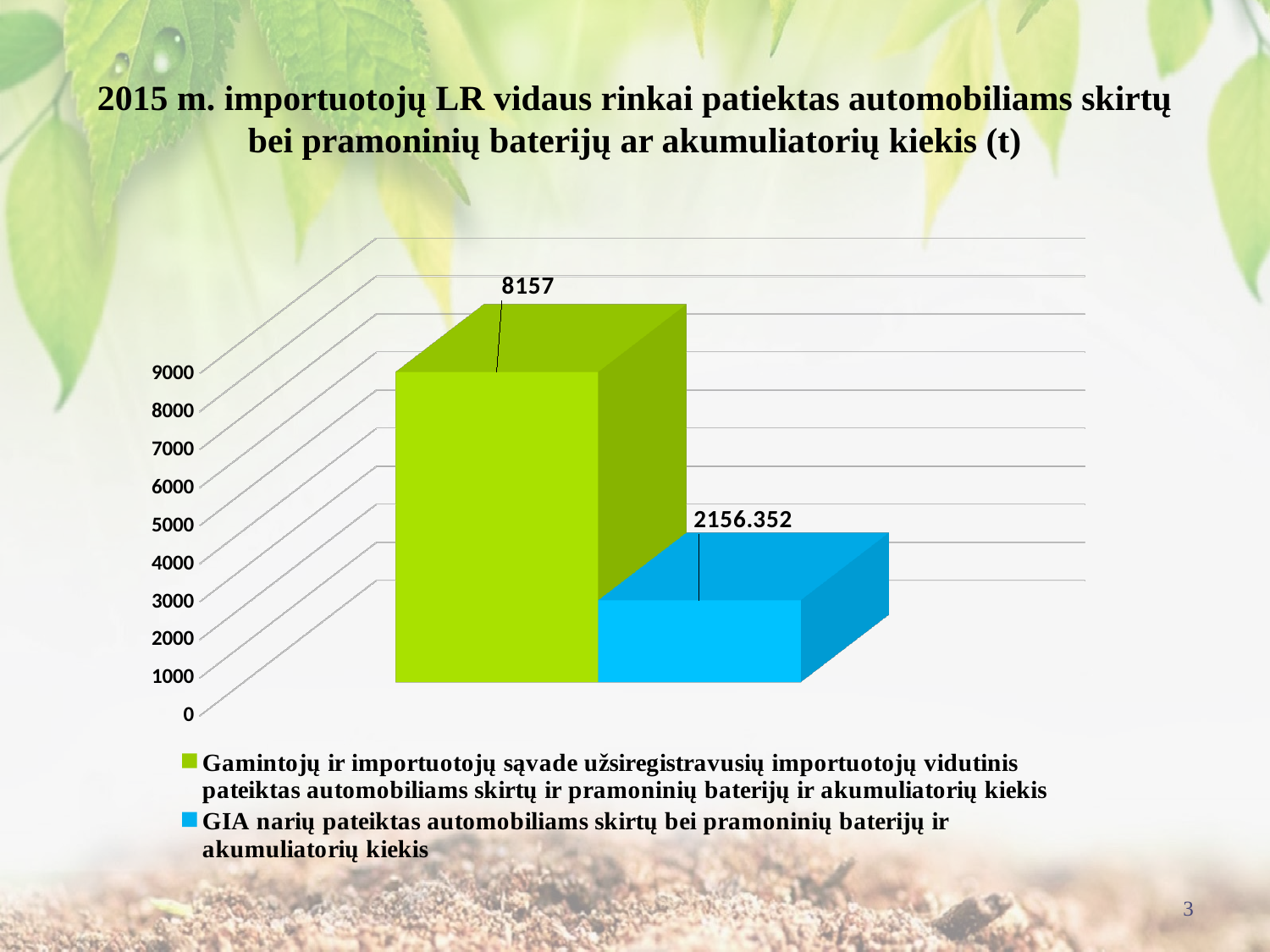
What value is shown for the green bar, 'Gamintojų ir importuotojų sąvade užsiregistravusių importuotojų vidutinis pateiktas automobiliams skirtų ir pramoninių baterijų ir akumuliatorių kiekis'? 8157 Is the value for the importuotojų vidutinis series greater or less than 8000? greater What kind of chart is shown on the slide? bar chart How many series does the legend list? 2 Which series has the higher value? Gamintojų ir importuotojų sąvade užsiregistravusių importuotojų vidutinis pateiktas automobiliams skirtų ir pramoninių baterijų ir akumuliatorių kiekis What value is shown for the blue bar, 'GIA narių pateiktas automobiliams skirtų bei pramoninių baterijų ir akumuliatorių kiekis'? 2156.352 Is the value for the GIA narių series larger or smaller than the value for the importuotojų vidutinis series? smaller What is the difference between the value for the green bar (8157) and the blue bar (2156.352)? 6000.648 Is the value for the GIA narių series greater or less than 3000? less How many bars are plotted on the chart? 2 Which series has the lower value? GIA narių pateiktas automobiliams skirtų bei pramoninių baterijų ir akumuliatorių kiekis What colour is the bar for the GIA narių series? blue